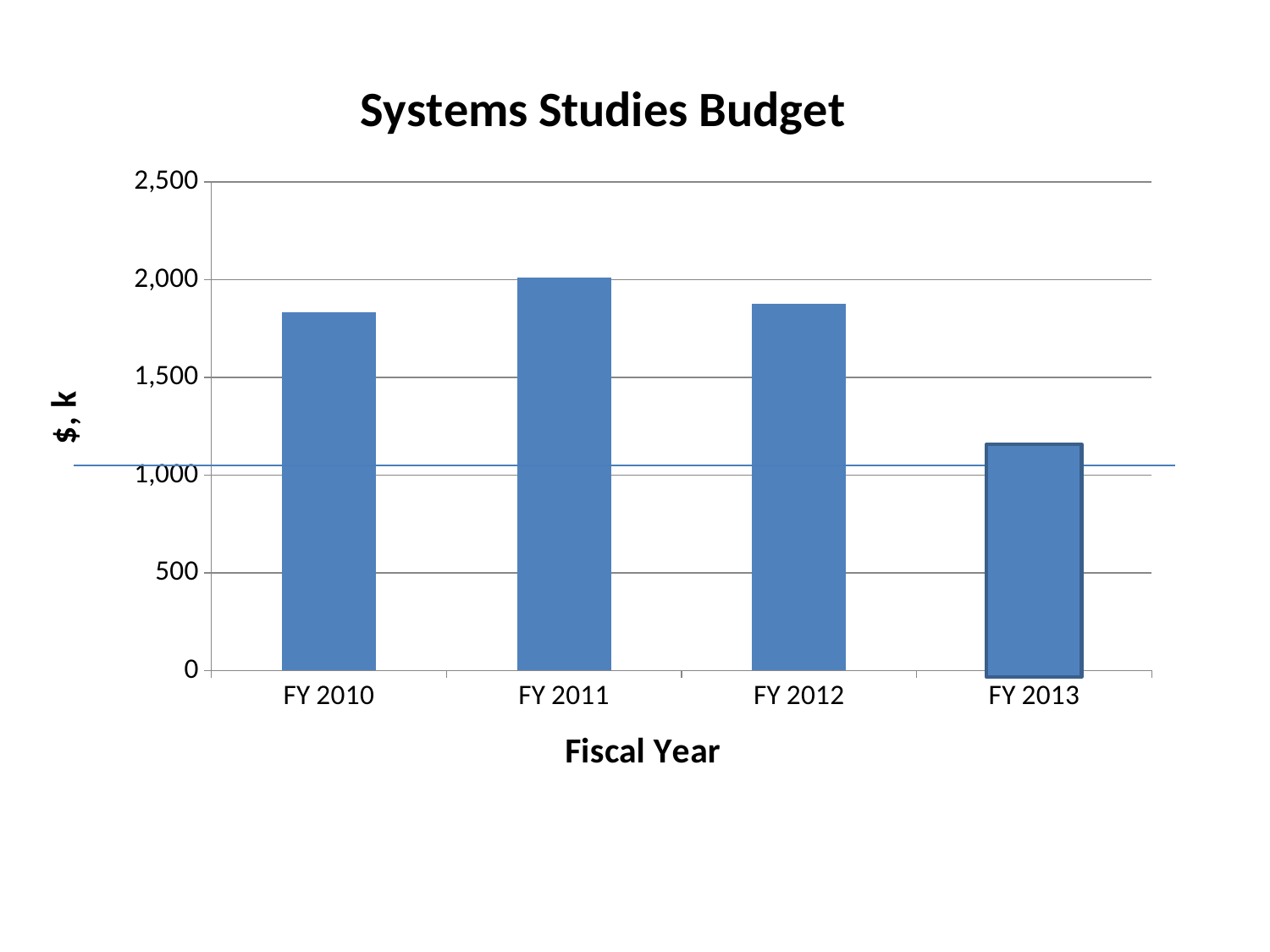
What kind of chart is shown on the slide? bar chart What is the title of the chart? Systems Studies Budget Which is larger, the budget for FY 2010 or FY 2011? FY 2011 Which is larger, the budget for FY 2011 or FY 2013? FY 2011 Which fiscal year has the lowest Systems Studies Budget? FY 2013 Which fiscal year has the highest Systems Studies Budget? FY 2011 How many fiscal years are plotted in the Systems Studies Budget chart? 4 What is the label on the vertical axis of the chart? $, k Is the value for FY 2013 greater or less than 1,000? greater Is the value for FY 2013 greater or less than 1,500? less Is the value for FY 2010 greater or less than 2,000? less